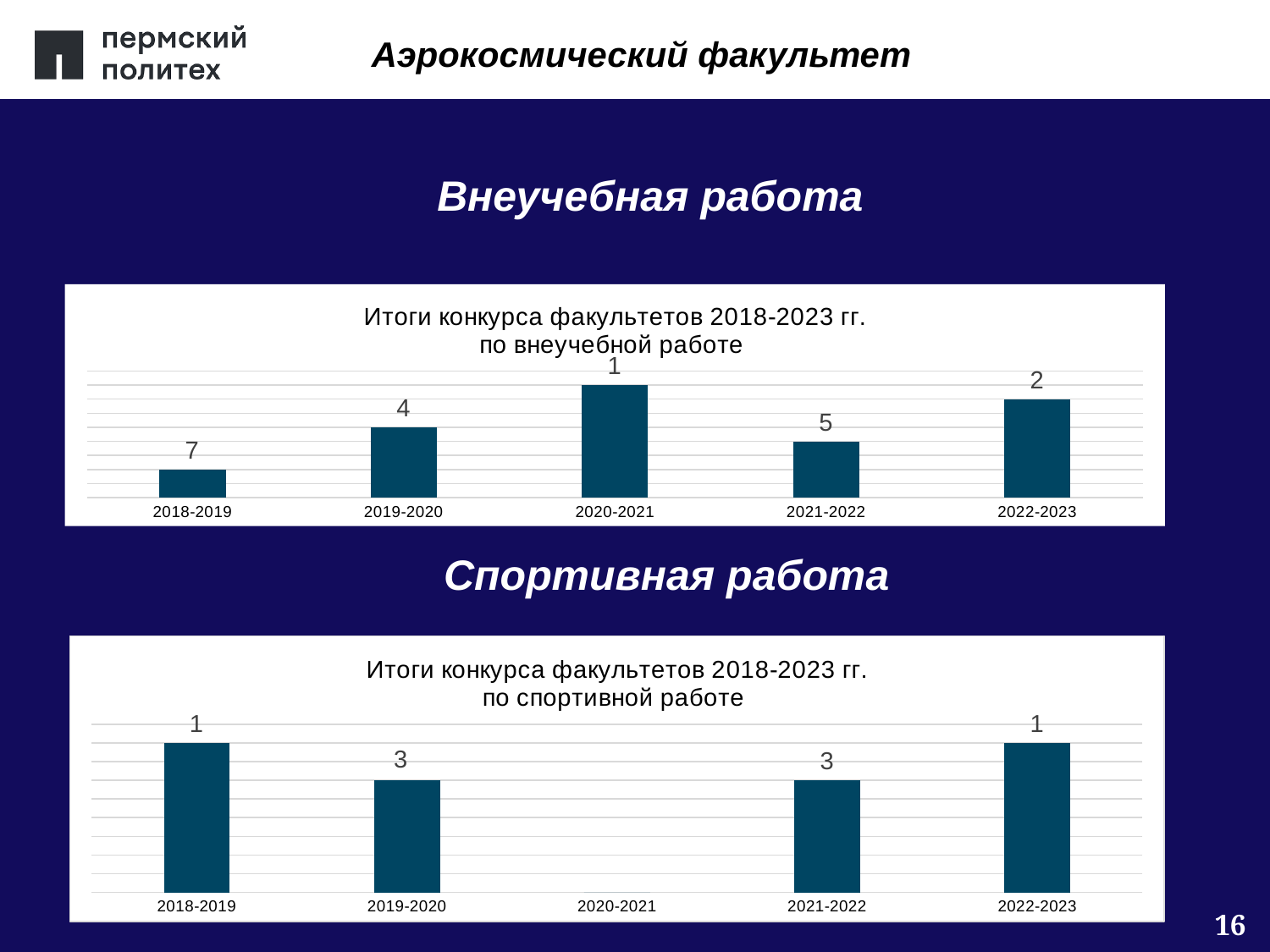
In the top chart (по внеучебной работе), what is the data label for 2020-2021? 1 In the top chart (по внеучебной работе), what is the difference between the data labels for 2018-2019 and 2019-2020? 3 In the bottom chart (по спортивной работе), what is the data label for 2022-2023? 1 In the bottom chart (по спортивной работе), which has the larger data label, 2018-2019 or 2021-2022? 2021-2022 In the bottom chart (по спортивной работе), what is the data label for 2019-2020? 3 In the top chart (по внеучебной работе), what is the data label for 2021-2022? 5 How many categories are shown on the x axis of the top chart (по внеучебной работе)? 5 In the top chart (по внеучебной работе), what is the data label for 2022-2023? 2 What kind of chart is the top chart (по внеучебной работе)? bar chart In the bottom chart (по спортивной работе), which x-axis category has no bar plotted? 2020-2021 What is the title of the bottom chart? Итоги конкурса факультетов 2018-2023 гг. по спортивной работе In the top chart (по внеучебной работе), what is the data label for 2018-2019? 7